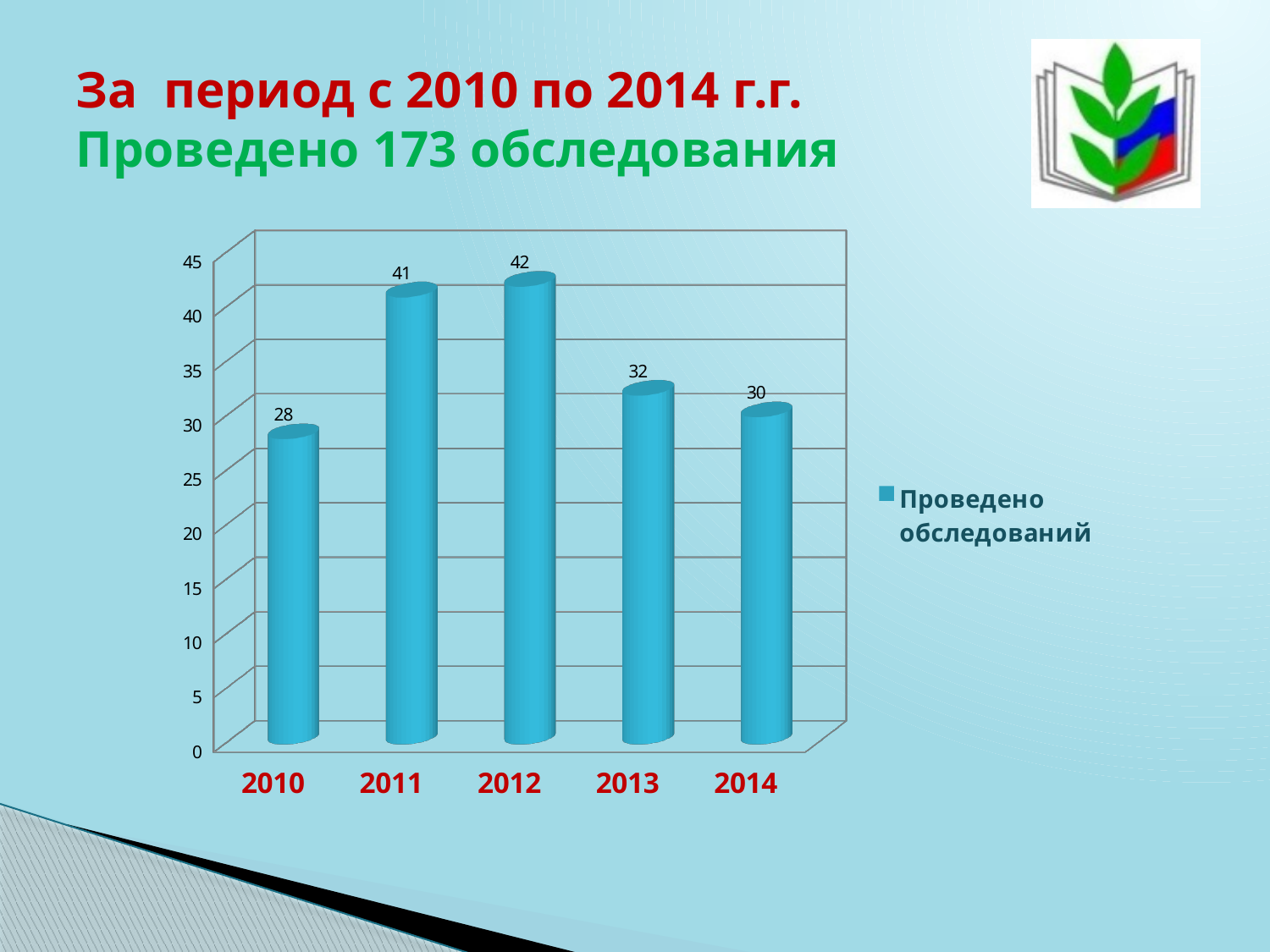
What is the legend entry for the series? Проведено обследований What is the value for 2014? 30 What is the value for 2012? 42 What is the difference between the values for 2011 and 2013? 9 Which year has the lowest value? 2010 Which year has the highest value? 2012 How many series does the legend list? 1 How many years are shown on the x axis? 5 What kind of chart is shown? bar chart Which is larger, the value for 2013 or the value for 2014? 2013 What is the value for 2010? 28 Is the value for 2011 greater or less than 40? greater